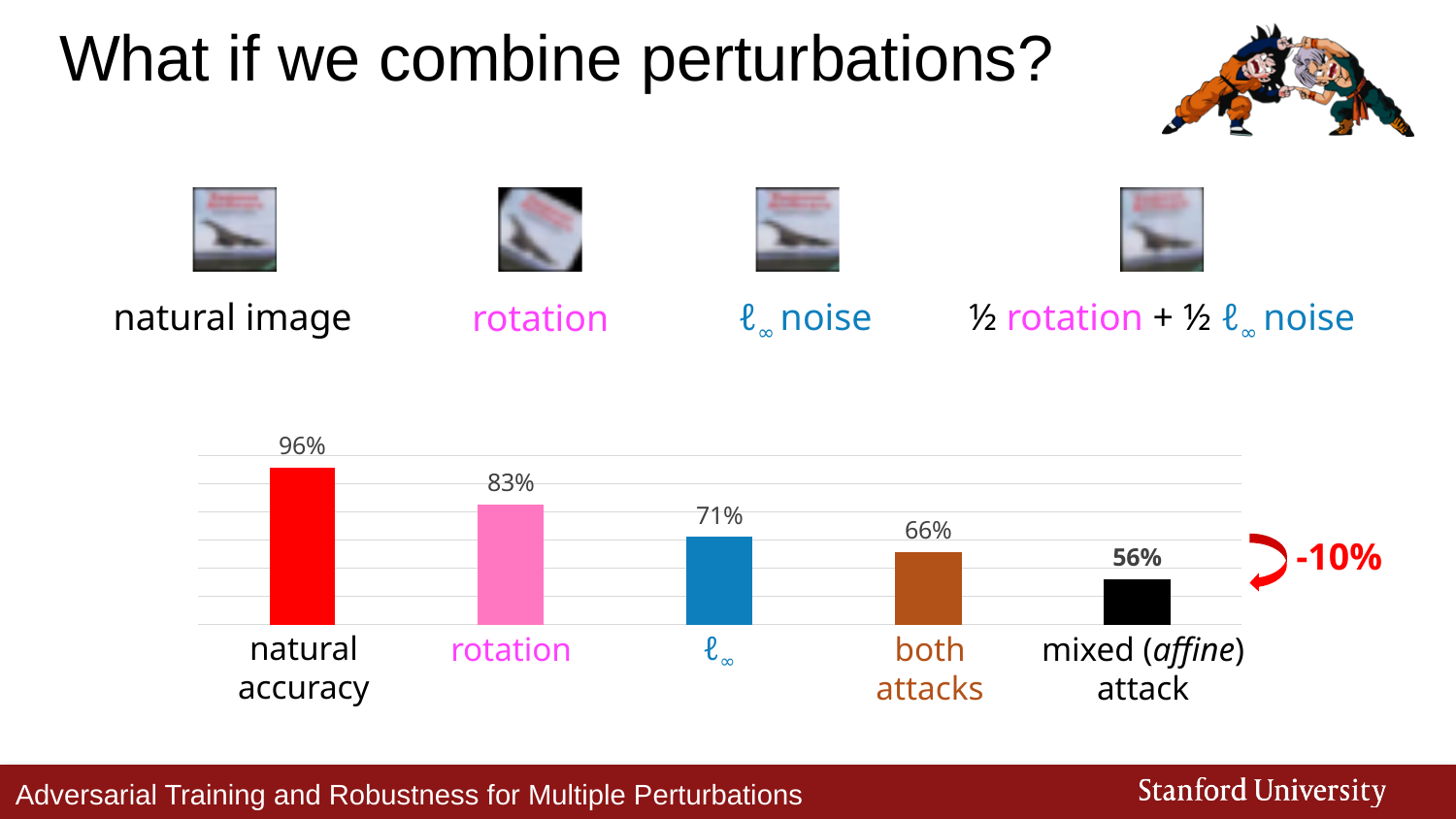
Which category has the lowest value? mixed (affine) attack What is the difference between the both attacks value and the mixed (affine) attack value? 10% What is the value for both attacks? 66% What is the value for the mixed (affine) attack? 56% Which category has the highest value? natural accuracy What is the difference between natural accuracy and the rotation value? 13% What is the value for natural accuracy? 96% What is the value for the rotation bar? 83% Which is larger, the value for rotation or the value for ℓ∞? rotation What kind of chart is shown? bar chart What is the value for the ℓ∞ bar? 71% How many bars are in the chart? 5